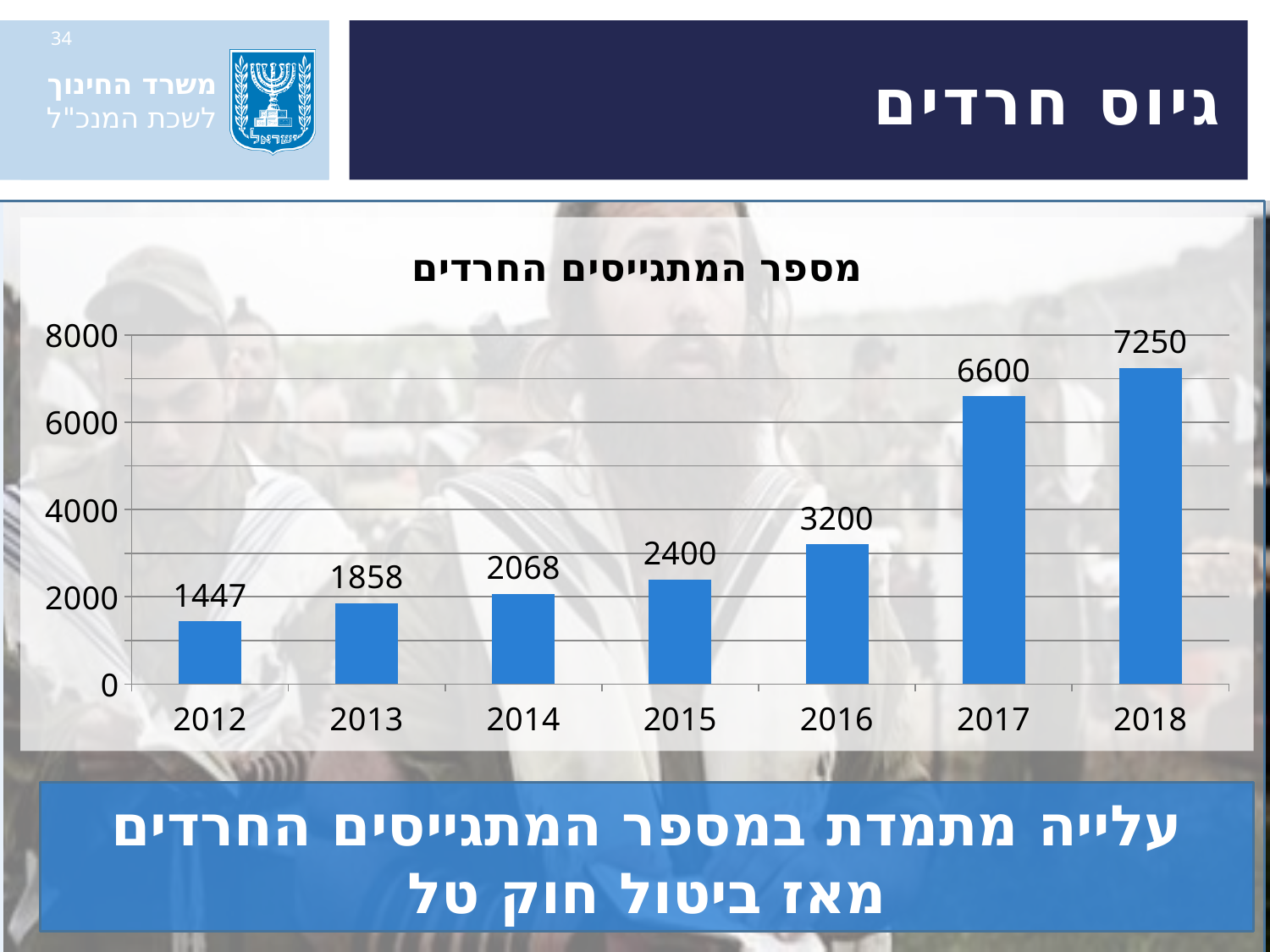
What is the difference between the values for 2018 and 2017? 650 How many years are shown on the x axis? 7 What is the value for 2012? 1447 Which year has the lowest value? 2012 Is the value for 2017 greater or less than 6000? greater What kind of chart is shown on the slide? bar chart Which is larger, the value for 2014 or the value for 2013? 2014 Which year has the highest value? 2018 What is the difference between the values for 2016 and 2015? 800 Do the values rise or fall from 2012 to 2018? rise What is the value for 2016? 3200 What is the value for 2018? 7250